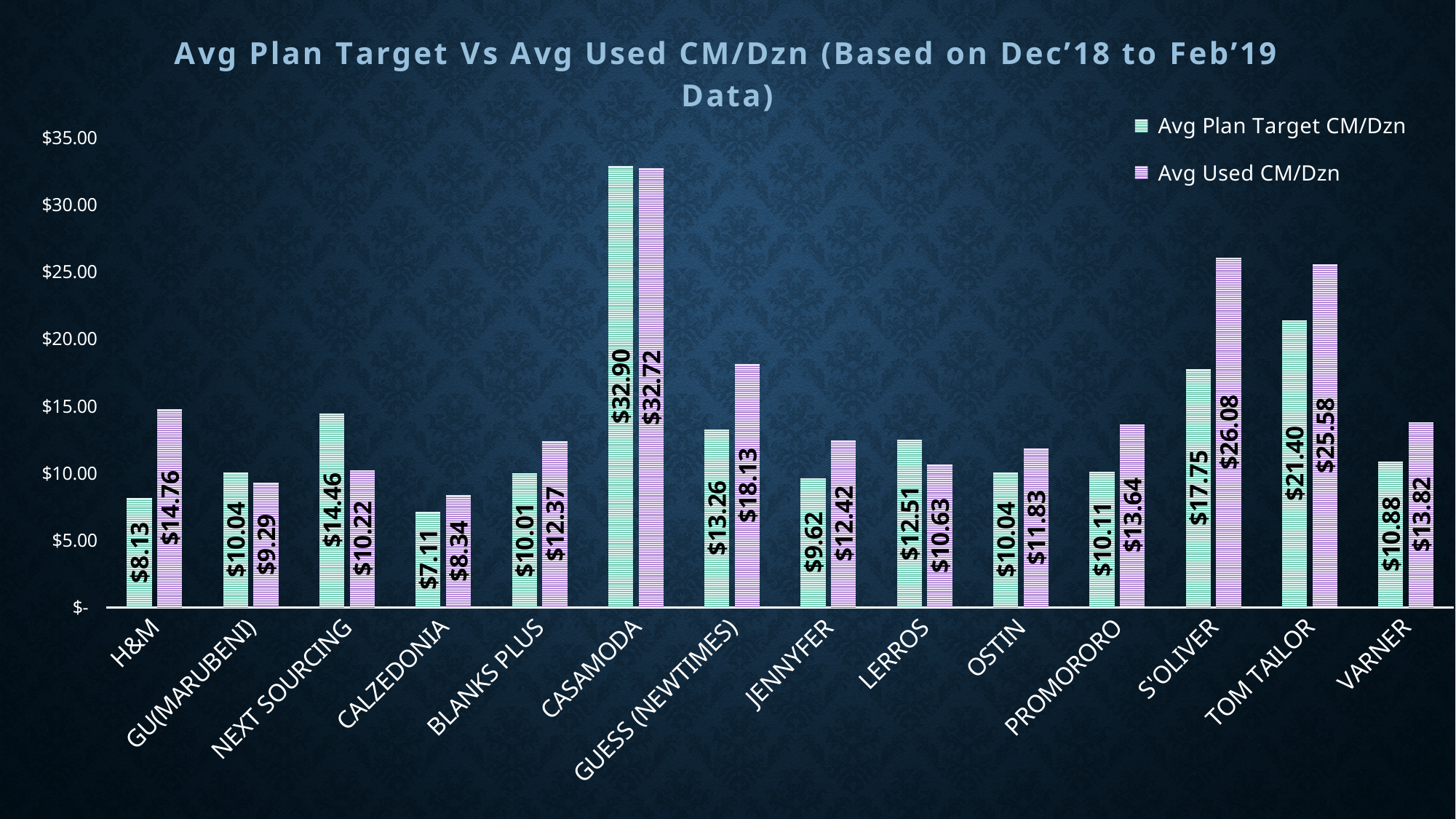
How many customers are shown on the x axis? 14 Which customer has the lowest Avg Used CM/Dzn? CALZEDONIA Is the Avg Used CM/Dzn for GUESS (NEWTIMES) greater or less than $15.00? greater What kind of chart is shown on the slide? Bar chart What is the difference between the Avg Used CM/Dzn and the Avg Plan Target CM/Dzn for TOM TAILOR? $4.18 For NEXT SOURCING, which is larger: the Avg Plan Target CM/Dzn or the Avg Used CM/Dzn? Avg Plan Target CM/Dzn What is the title of the chart? Avg Plan Target Vs Avg Used CM/Dzn (Based on Dec'18 to Feb'19 Data) What is the Avg Used CM/Dzn for H&M? $14.76 Which customer has the highest Avg Plan Target CM/Dzn? CASAMODA What is the Avg Used CM/Dzn for S'OLIVER? $26.08 What is the Avg Plan Target CM/Dzn for CASAMODA? $32.90 How many series does the legend list? 2